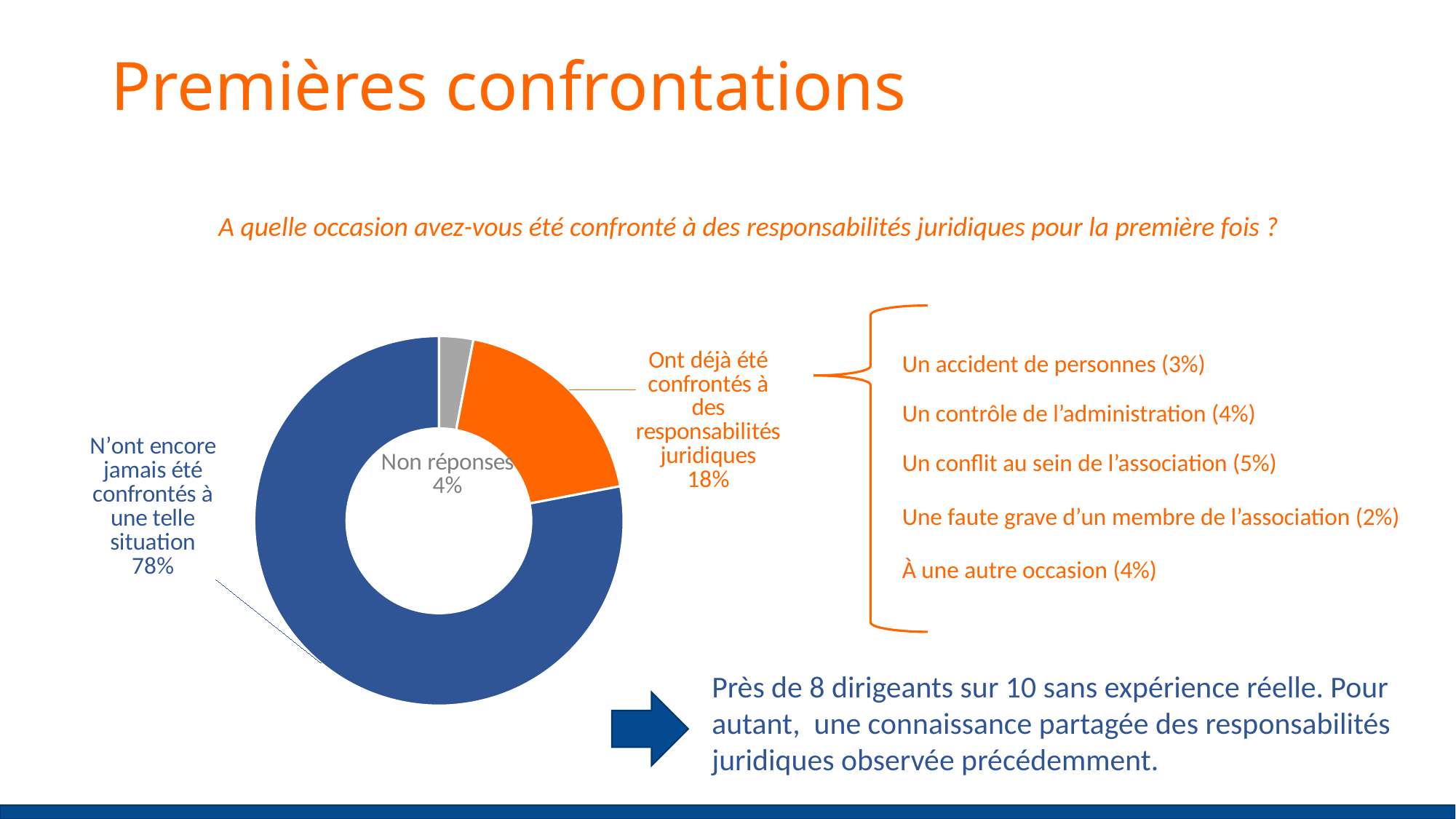
What percentage of the chart is 'Non réponses'? 4% What kind of chart is shown on the slide? Doughnut chart How many slices does the doughnut chart have? 3 Which slice of the doughnut chart is the largest? N'ont encore jamais été confrontés à une telle situation What question does the chart answer, according to the italic text above it? A quelle occasion avez-vous été confronté à des responsabilités juridiques pour la première fois ? What colour is the slice representing 'Ont déjà été confrontés à des responsabilités juridiques'? Orange What percentage of respondents have never yet been confronted with such a situation (N'ont encore jamais été confrontés à une telle situation)? 78% Which slice of the doughnut chart is the smallest? Non réponses What is the difference in percentage points between those who have never been confronted (78%) and those who have already been confronted (18%)? 60 According to the breakdown next to the chart, what percentage corresponds to 'Un conflit au sein de l'association'? 5% What percentage of respondents have already been confronted with legal responsibilities (Ont déjà été confrontés à des responsabilités juridiques)? 18% Which is larger: the share for 'Ont déjà été confrontés à des responsabilités juridiques' or the share for 'Non réponses'? Ont déjà été confrontés à des responsabilités juridiques